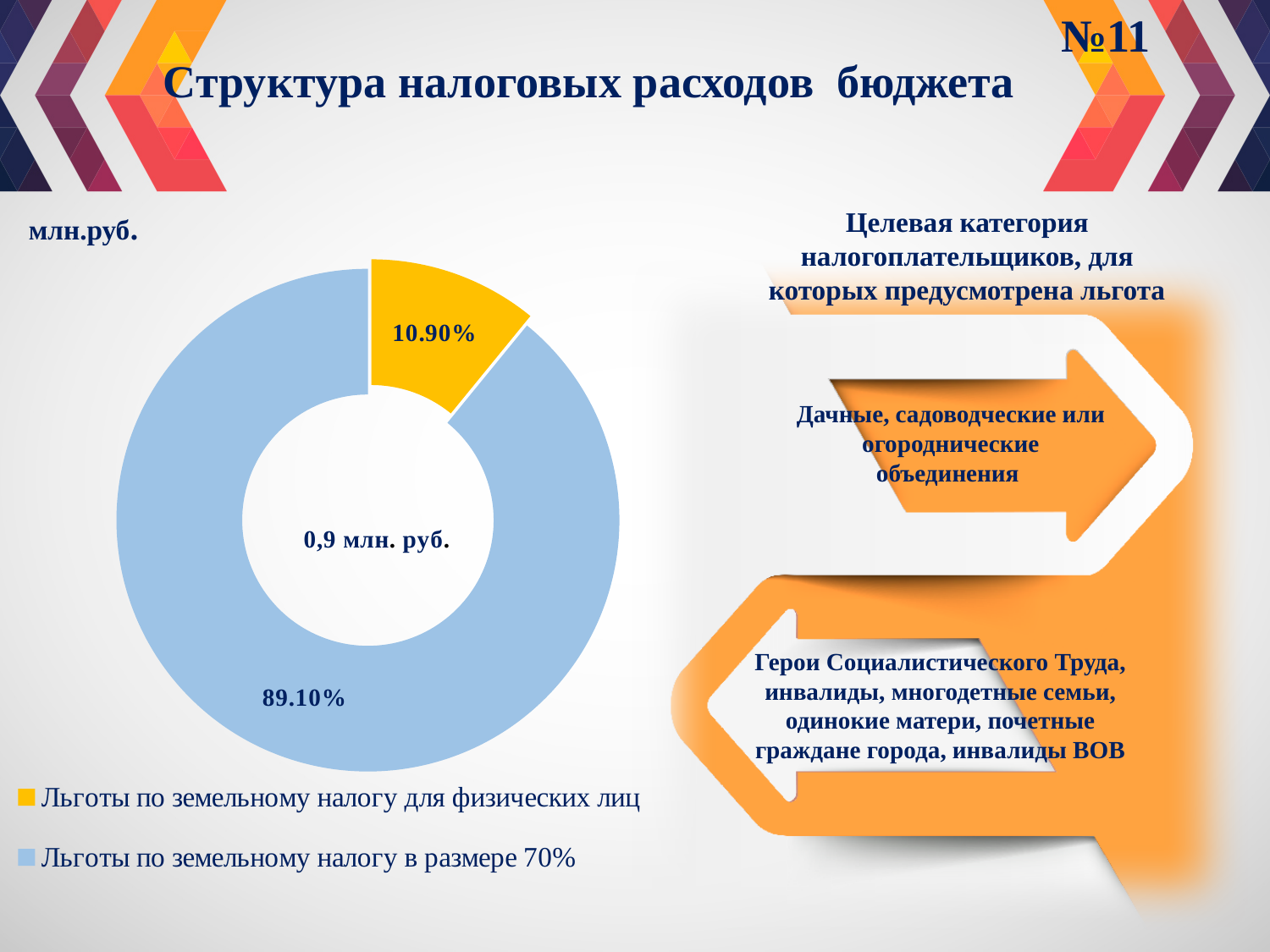
What kind of chart is shown on the slide? Doughnut (pie) chart What value is printed in the centre of the doughnut chart? 0,9 млн. руб. Which category has the smallest share of the chart? Льготы по земельному налогу для физических лиц What is the difference in percentage points between the two slices of the chart? 78.20 percentage points What is the title of the slide containing the chart? Структура налоговых расходов бюджета Which category has the largest share of the chart? Льготы по земельному налогу в размере 70% How many slices does the chart have? 2 What share of the chart is labelled "Льготы по земельному налогу для физических лиц"? 10.90% How many entries does the chart legend list? 2 Which slice is larger: "Льготы по земельному налогу для физических лиц" or "Льготы по земельному налогу в размере 70%"? Льготы по земельному налогу в размере 70% What colour is the slice for "Льготы по земельному налогу для физических лиц"? Yellow What share of the chart is labelled "Льготы по земельному налогу в размере 70%"? 89.10%